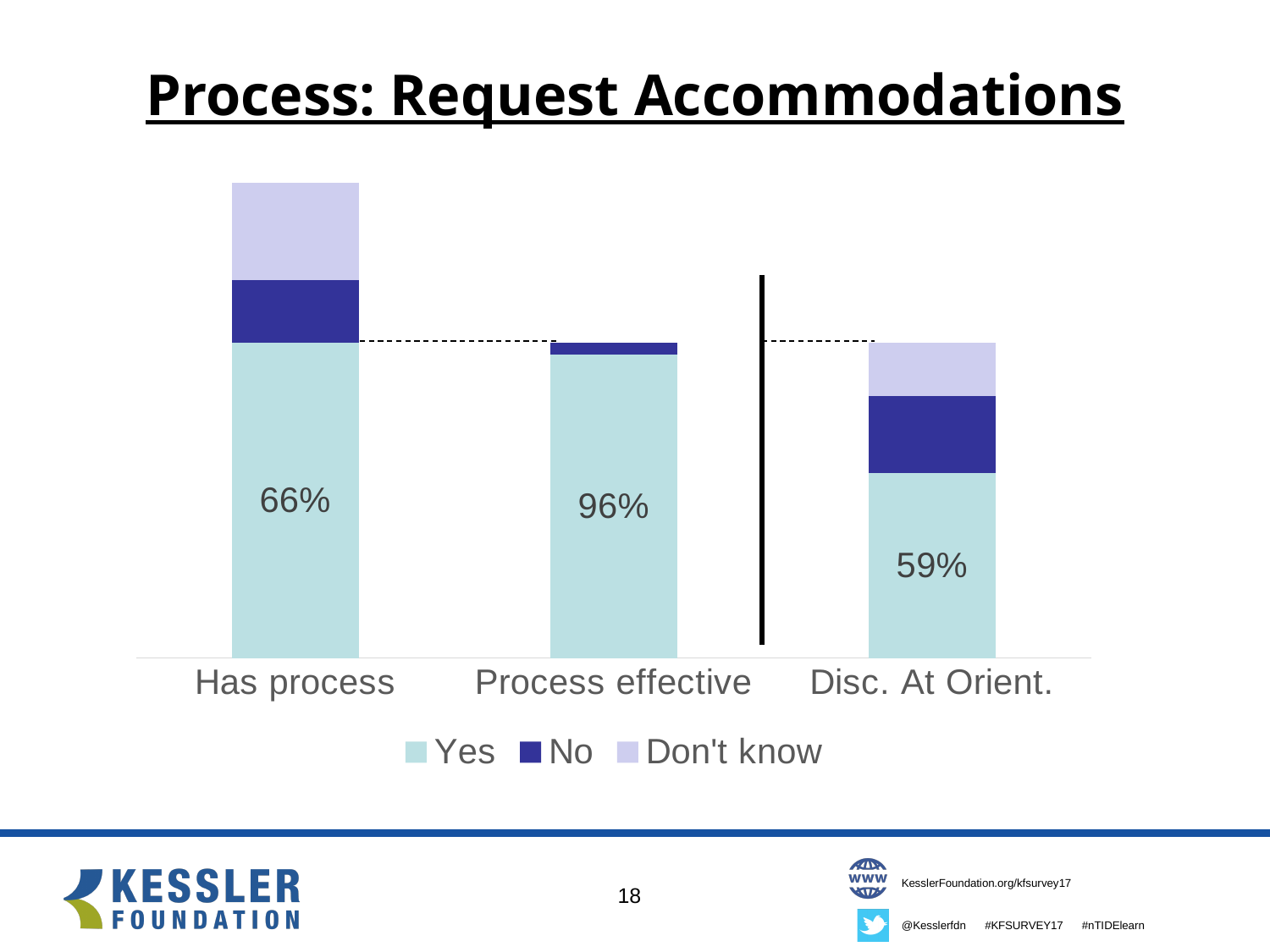
How many series does the legend list? 3 What are the three entries in the chart legend? Yes, No, Don't know What is the difference between the "Yes" values for "Process effective" and "Has process"? 30 percentage points Which has a larger "Yes" value, "Has process" or "Disc. At Orient."? Has process How many categories are shown on the x axis? 3 What is the "Yes" value for "Has process"? 66% What is the "Yes" value for "Disc. At Orient."? 59% What is the difference between the "Yes" values for "Has process" and "Disc. At Orient."? 7 percentage points What is the "Yes" value for "Process effective"? 96% What kind of chart is shown on the slide? Stacked bar chart Which category has the lowest "Yes" value? Disc. At Orient. Which category has the highest "Yes" value? Process effective